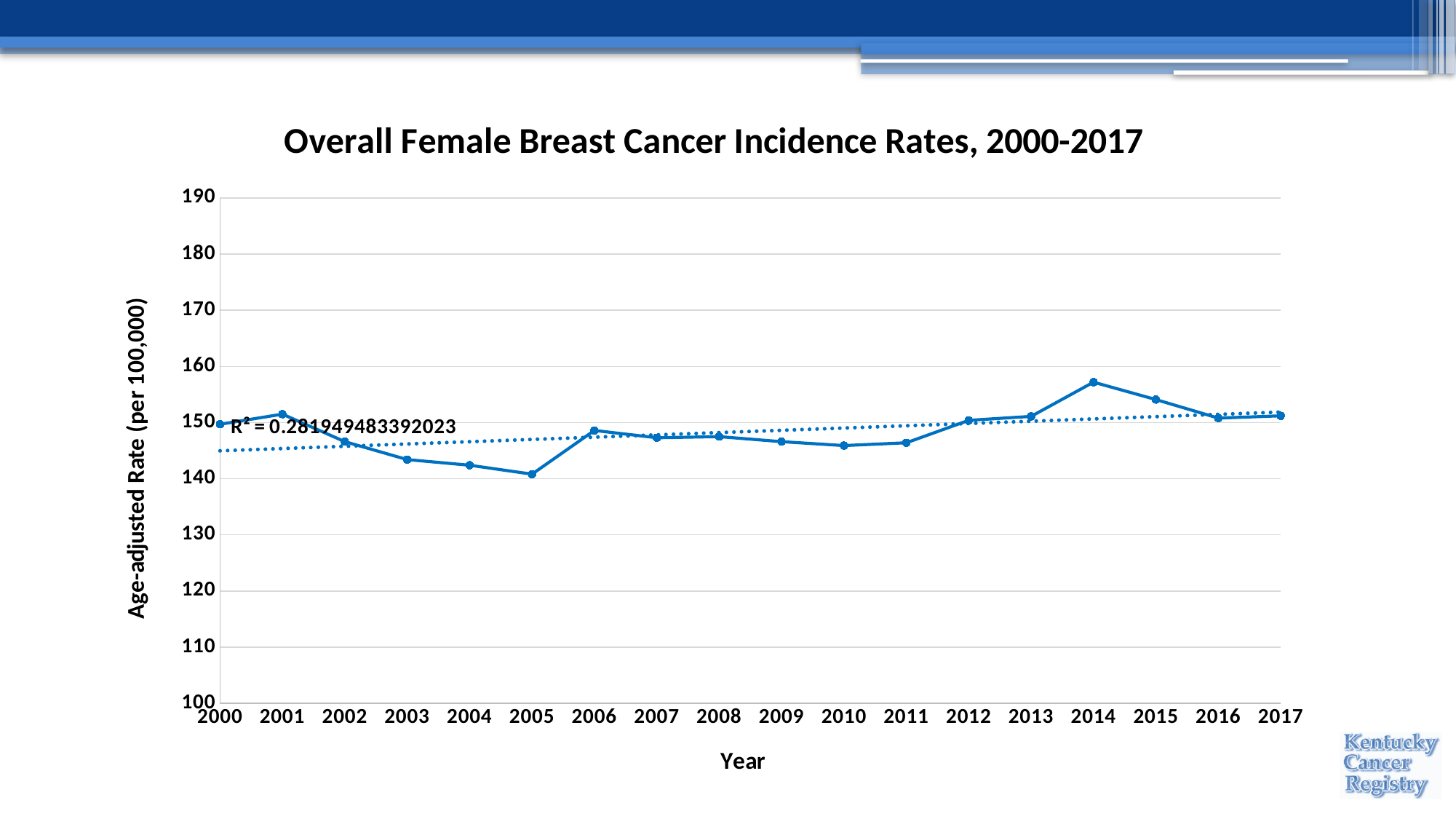
Is the value for 2014 greater or less than 160? less Which year has the lowest incidence rate? 2005 Is the value for 2010 greater or less than 150? less What kind of chart is shown on the slide? line chart Is the value for 2005 greater or less than 150? less How many years are plotted on the x axis? 18 Which year has the larger incidence rate, 2015 or 2010? 2015 According to the dotted trendline, do incidence rates rise or fall from 2000 to 2017 overall? rise What R² value is printed on the chart? R² = 0.281949483392023 Which year has the highest incidence rate? 2014 What is the title of the chart? Overall Female Breast Cancer Incidence Rates, 2000-2017